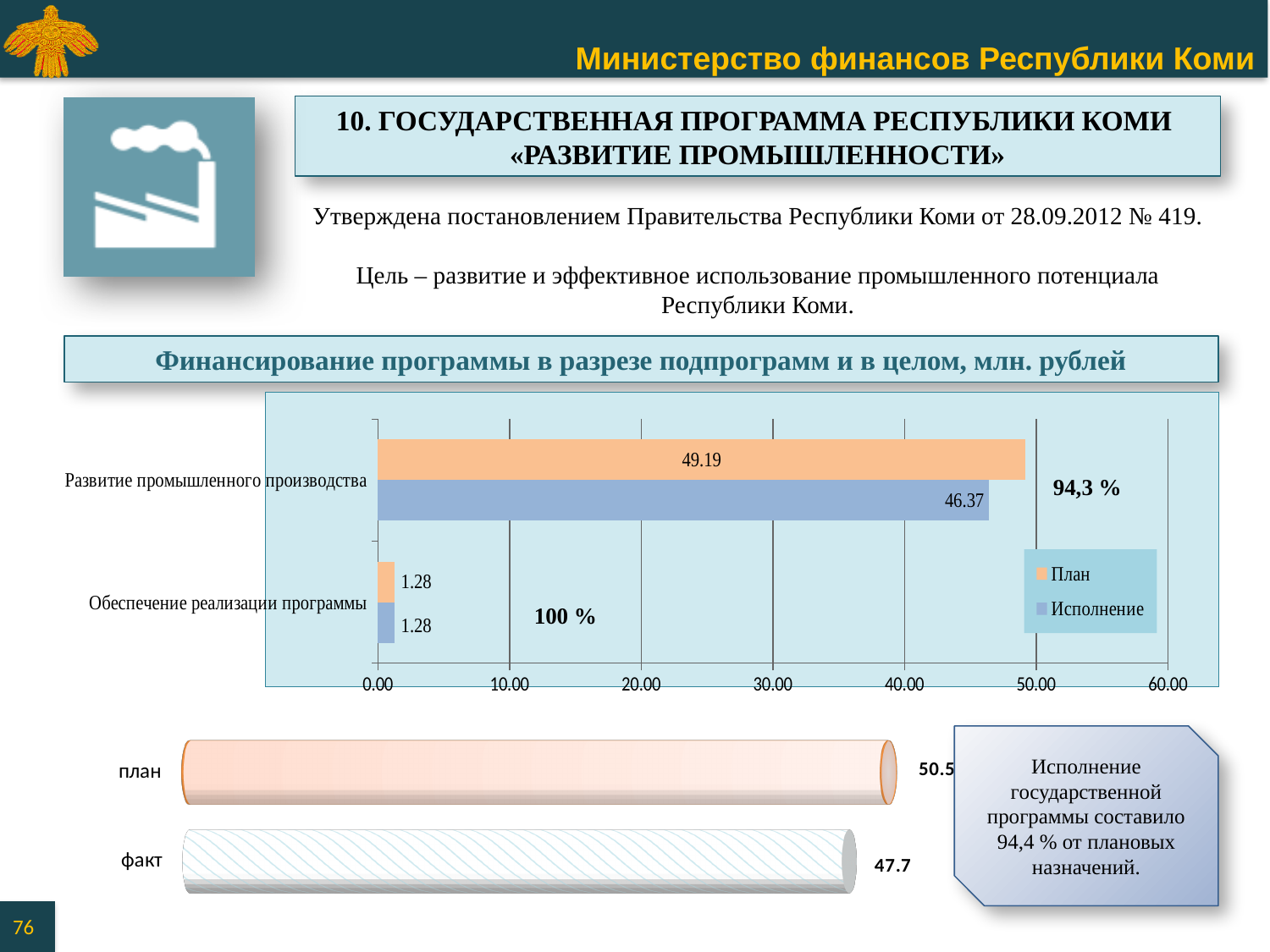
In the lower chart, what is the value for факт? 47.7 In the upper bar chart, what is the Исполнение value for Обеспечение реализации программы? 1.28 In the upper bar chart, what is the Исполнение value for Развитие промышленного производства? 46.37 In the upper bar chart, how many series does the legend list? 2 In the upper bar chart, which category has the higher План value? Развитие промышленного производства In the upper bar chart, what is the difference between the План and Исполнение values for Развитие промышленного производства? 2.82 In the upper bar chart, how many categories are shown? 2 In the upper bar chart, what are the two legend entries? План, Исполнение In the lower chart, what is the value for план? 50.5 What kind of chart is the upper chart on the slide? Bar chart In the upper bar chart, what is the План value for Развитие промышленного производства? 49.19 In the lower chart, what is the difference between план and факт? 2.8